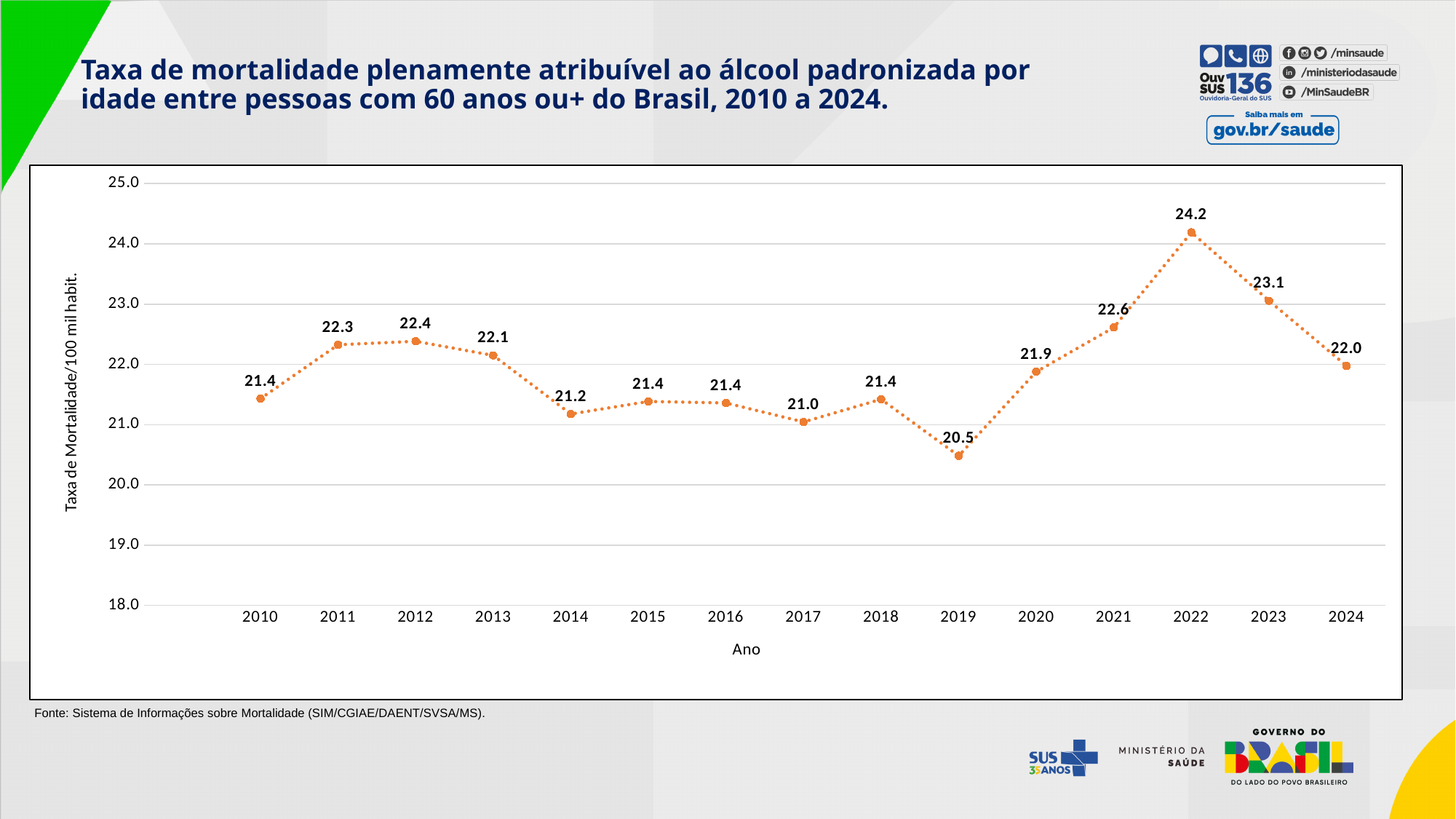
What is the difference between the mortality rate in 2022 and in 2019? 3.7 What is the mortality rate for 2010? 21.4 What is the mortality rate for 2022? 24.2 Which year has the lowest mortality rate? 2019 What kind of chart is shown on the slide? Line chart Which year has a higher mortality rate, 2021 or 2023? 2023 How many years are plotted on the x axis? 15 Is the value for 2022 greater or less than 24.0? greater What is the mortality rate for 2019? 20.5 Does the mortality rate rise or fall from 2019 to 2022? Rise Which year has the highest mortality rate? 2022 What is the label of the x axis? Ano